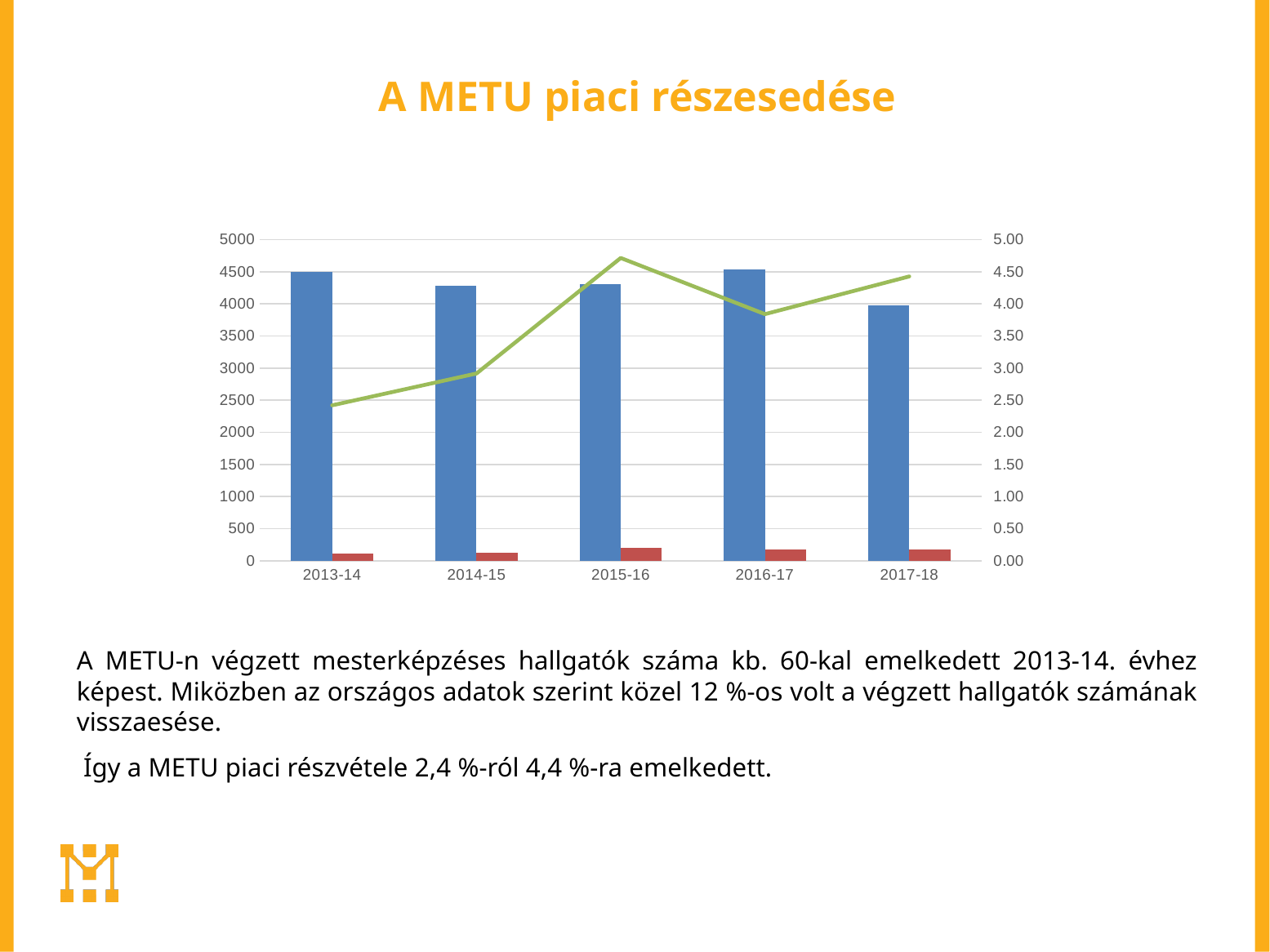
Is the blue bar for 2013-14 greater or less than 4000? greater Which year has the lowest blue bar? 2017-18 What kind of chart is shown on the slide? A bar chart combined with a line chart In which year does the green line reach its highest point? 2015-16 Which is larger, the blue bar for 2013-14 or the blue bar for 2017-18? 2013-14 Is the green line value for 2015-16 greater or less than 4.50 on the right axis? greater Does the green line generally rise or fall from 2013-14 to 2017-18? rise How many academic years are shown on the x axis of the chart? 5 Is the red bar for 2015-16 greater or less than 500? less In which year is the green line at its lowest point? 2013-14 What is the title of the chart? A METU piaci részesedése